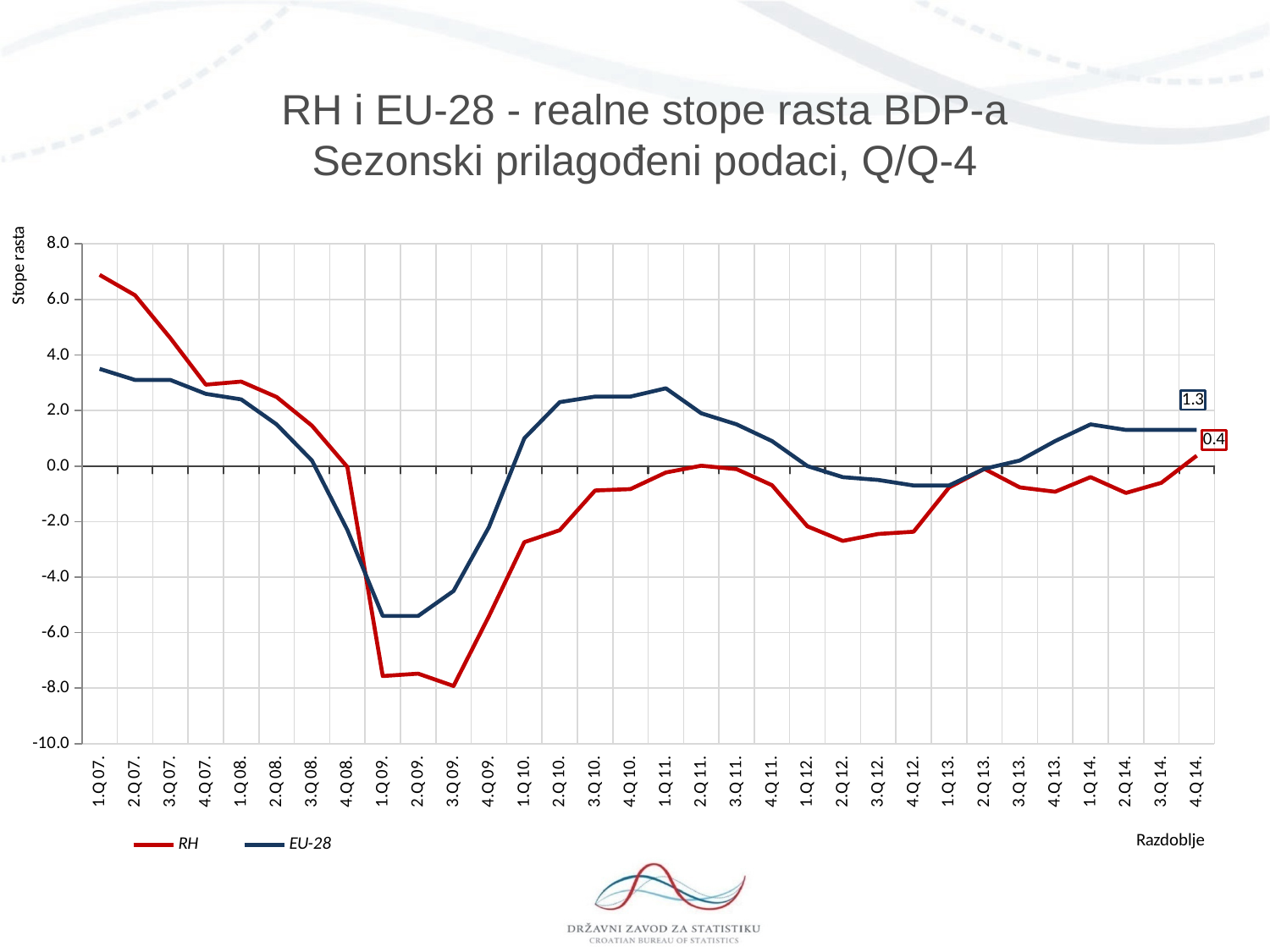
At 4.Q 14., which series has the higher value, RH or EU-28? EU-28 What is the value for EU-28 at 4.Q 14.? 1.3 How many series does the legend list? 2 Does the RH series rise or fall from 1.Q 07. to 1.Q 09.? fall How many periods are shown on the x axis? 32 What kind of chart is shown on the slide? line chart Is the value for RH at 1.Q 07. greater or less than 6.0? greater What is the value for RH at 4.Q 14.? 0.4 What is the difference between the EU-28 and RH values at 4.Q 14.? 0.9 In which period does the RH series reach its highest value? 1.Q 07. Is the value for RH at 1.Q 09. greater or less than -6.0? less Is the value for EU-28 at 1.Q 09. greater or less than -4.0? less